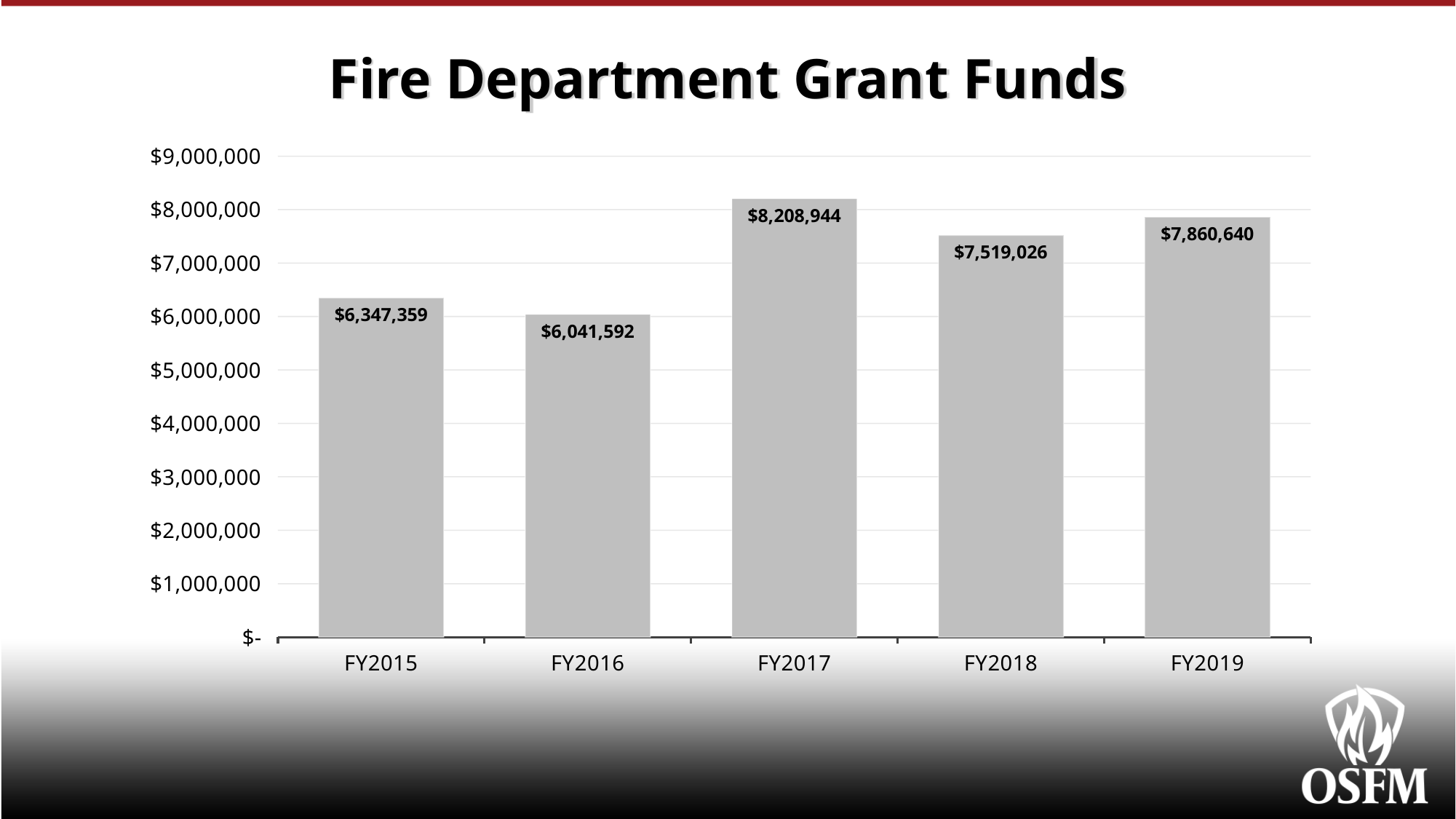
What is the value for FY2017? $8,208,944 What is the difference between the FY2015 and FY2016 values? $305,767 What kind of chart is shown on the slide? bar chart Which fiscal year has the lowest grant funds? FY2016 What is the title of the chart? Fire Department Grant Funds Which fiscal year has the highest grant funds? FY2017 Which is larger, the value for FY2018 or the value for FY2019? FY2019 What is the value for FY2016? $6,041,592 How many fiscal years are shown on the chart? 5 What is the value for FY2019? $7,860,640 Is the value for FY2015 greater or less than $6,000,000? greater What is the difference between the FY2017 and FY2018 values? $689,918